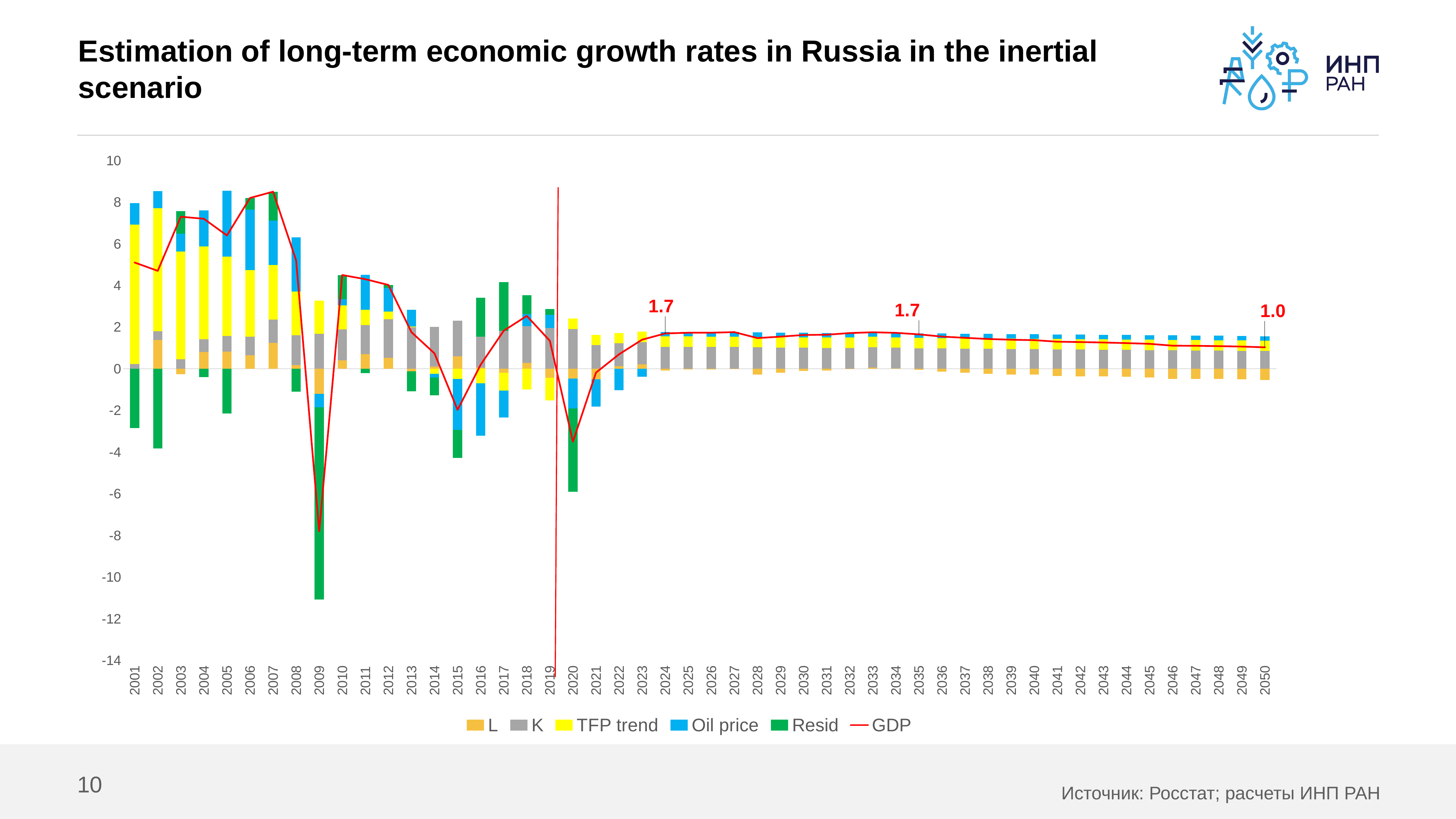
What is the difference between the labelled GDP values for 2024 and 2050? 0.7 Which year has the larger labelled GDP value, 2024 or 2050? 2024 What is the GDP value labelled for 2035? 1.7 Is the GDP value for 2009 greater or less than -6? less Does the GDP line rise or fall between 2035 and 2050? fall What kind of chart is shown on the slide? Stacked bar chart with a line How many years are shown on the x axis? 50 In which year does the GDP line reach its lowest point? 2009 Which colour represents the Resid series in the legend? Green What is the GDP value labelled for 2050? 1.0 What is the GDP value labelled for 2024? 1.7 How many series does the legend list? 6